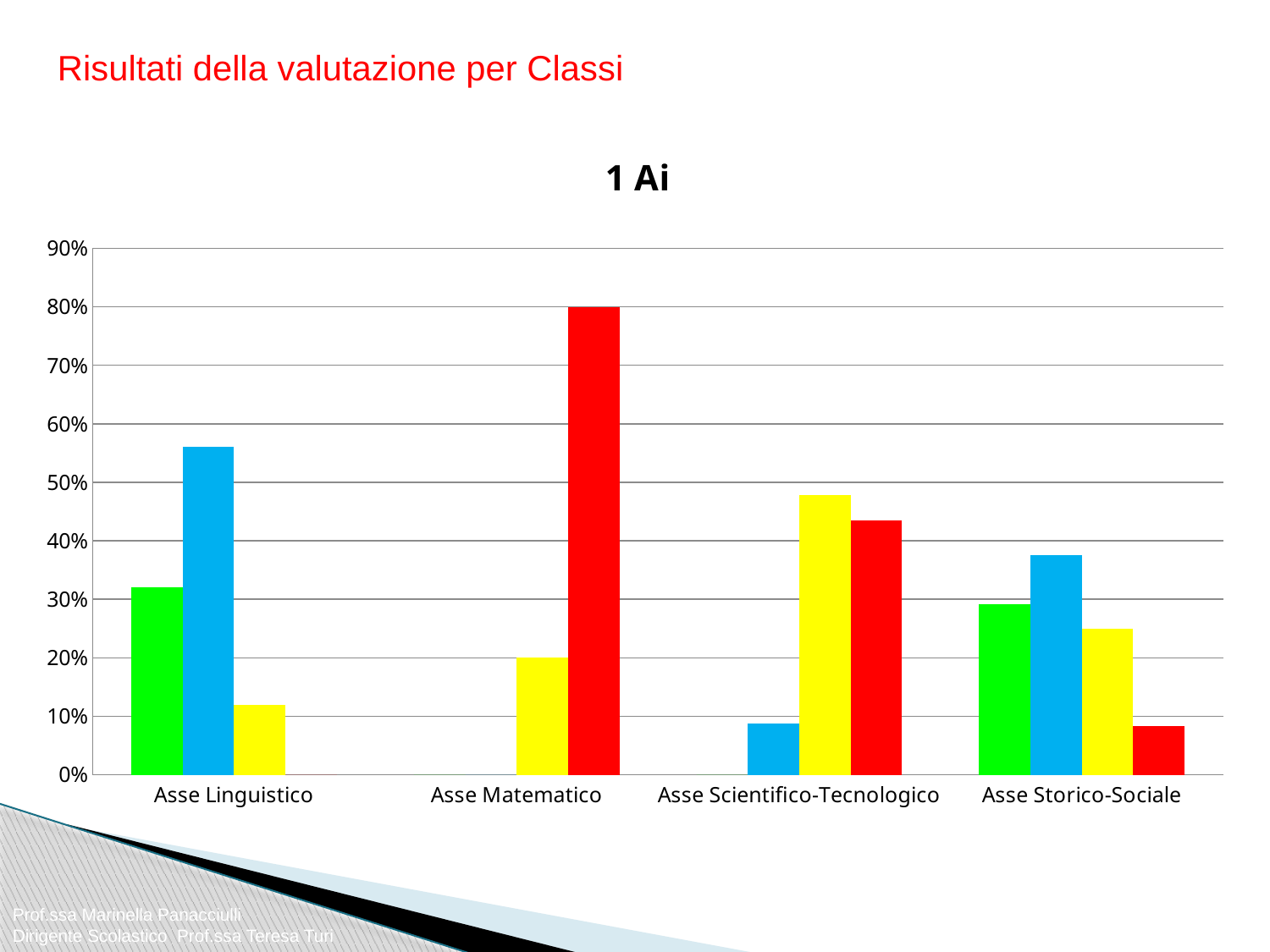
Which category has the tallest bar in the chart? Asse Matematico Which is larger for Asse Storico-Sociale, the blue bar or the red bar? blue bar What is the value of the yellow bar for Asse Matematico? 20% Is the value of the blue bar for Asse Scientifico-Tecnologico greater or less than 10%? less Is the value of the yellow bar for Asse Scientifico-Tecnologico greater or less than 40%? greater Is the value of the blue bar for Asse Linguistico greater or less than 50%? greater What is the value of the red bar for Asse Matematico? 80% How many categories are shown on the x axis? 4 What is the title of the chart? 1 Ai What kind of chart is shown on the slide? bar chart What is the difference between the red bar and the yellow bar for Asse Matematico? 60% Which is larger for Asse Linguistico, the green bar or the yellow bar? green bar